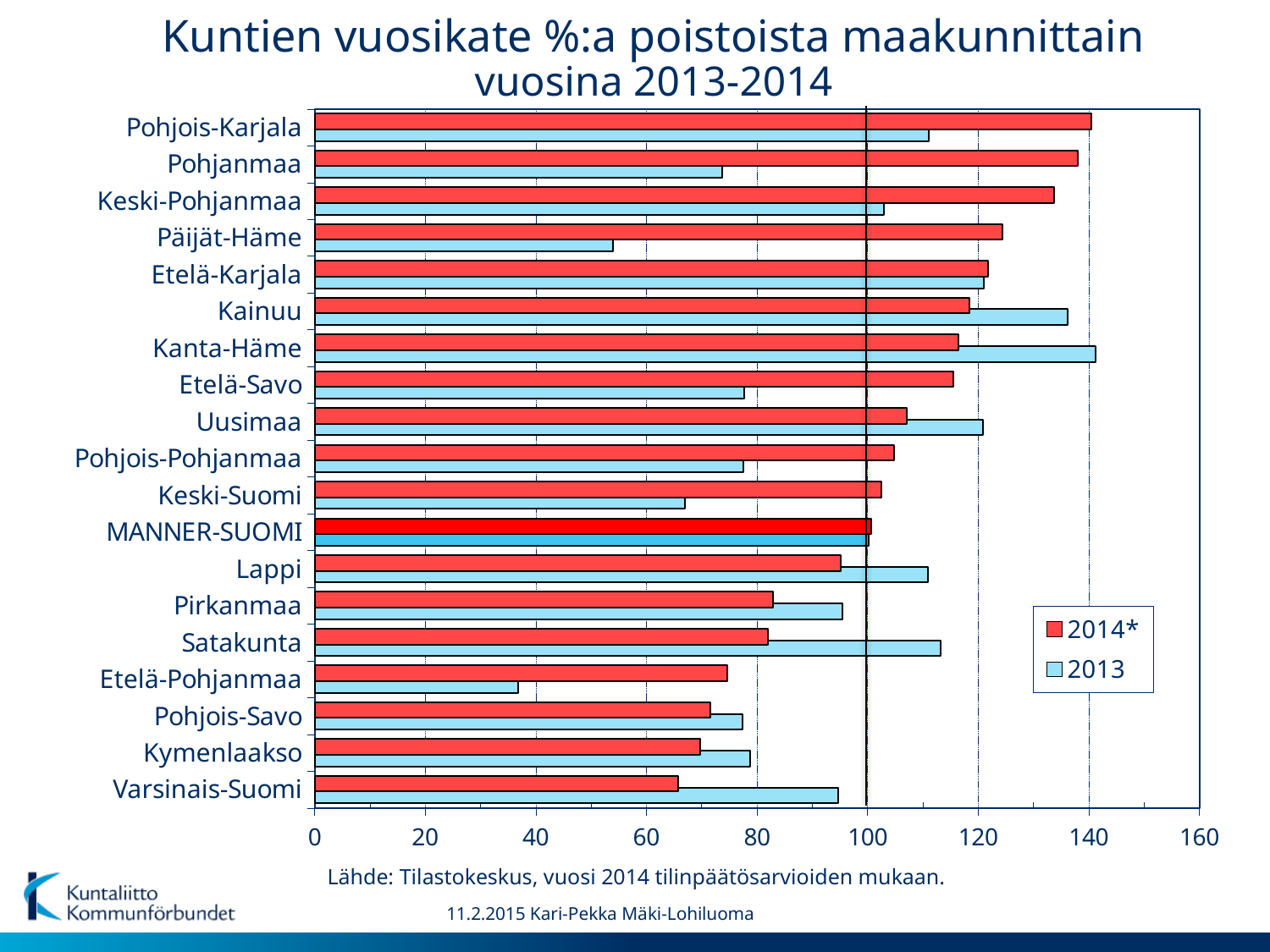
Is the 2013 value for Satakunta greater or less than 100? greater Which region has the highest 2013 value? Kanta-Häme For Päijät-Häme, which is larger: the 2014* value or the 2013 value? 2014* How many regions (categories) are plotted on the chart? 19 What kind of chart is shown on the slide? bar chart Which region has the lowest 2014* value? Varsinais-Suomi Is the 2014* value for Pohjanmaa greater or less than 120? greater Is the 2013 value for Päijät-Häme greater or less than 60? less For Kainuu, which is larger: the 2014* value or the 2013 value? 2013 Which region has the lowest 2013 value? Etelä-Pohjanmaa What are the two entries listed in the legend? 2014* and 2013 How many series does the legend list? 2